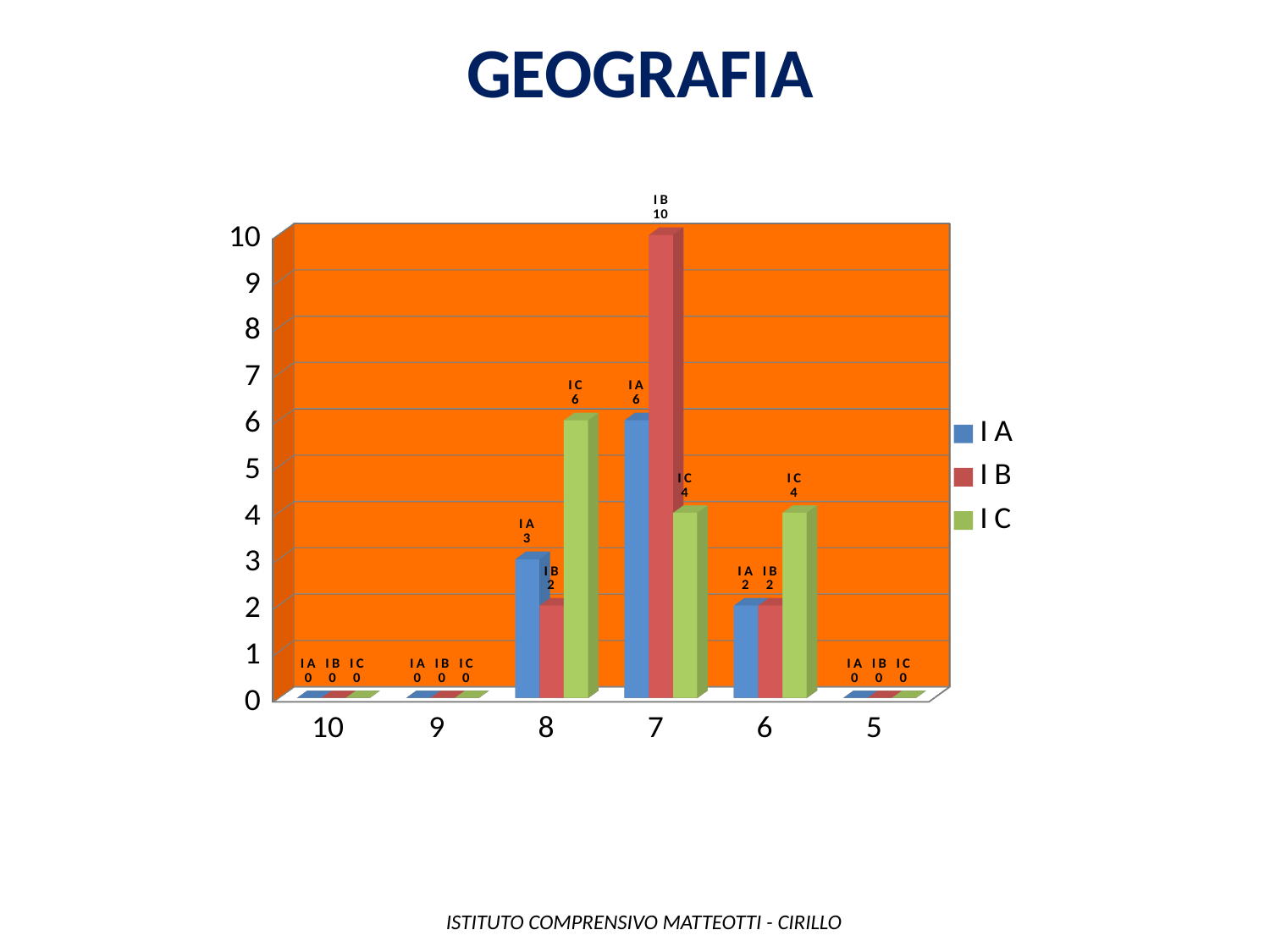
What is the difference between the I B value and the I A value at category 7? 4 How many categories are shown on the x axis? 6 Which is larger: the I A value at category 8 or the I C value at category 6? I C at category 6 Which series has the highest value at category 7? I B What is the value for I B at category 7? 10 What is the value for I C at category 5? 0 What is the title of the chart? GEOGRAFIA What is the value for I C at category 8? 6 How many series does the legend list? 3 What is the value for I A at category 6? 2 Which series has the lowest value at category 8? I B What kind of chart is shown on the slide? bar chart